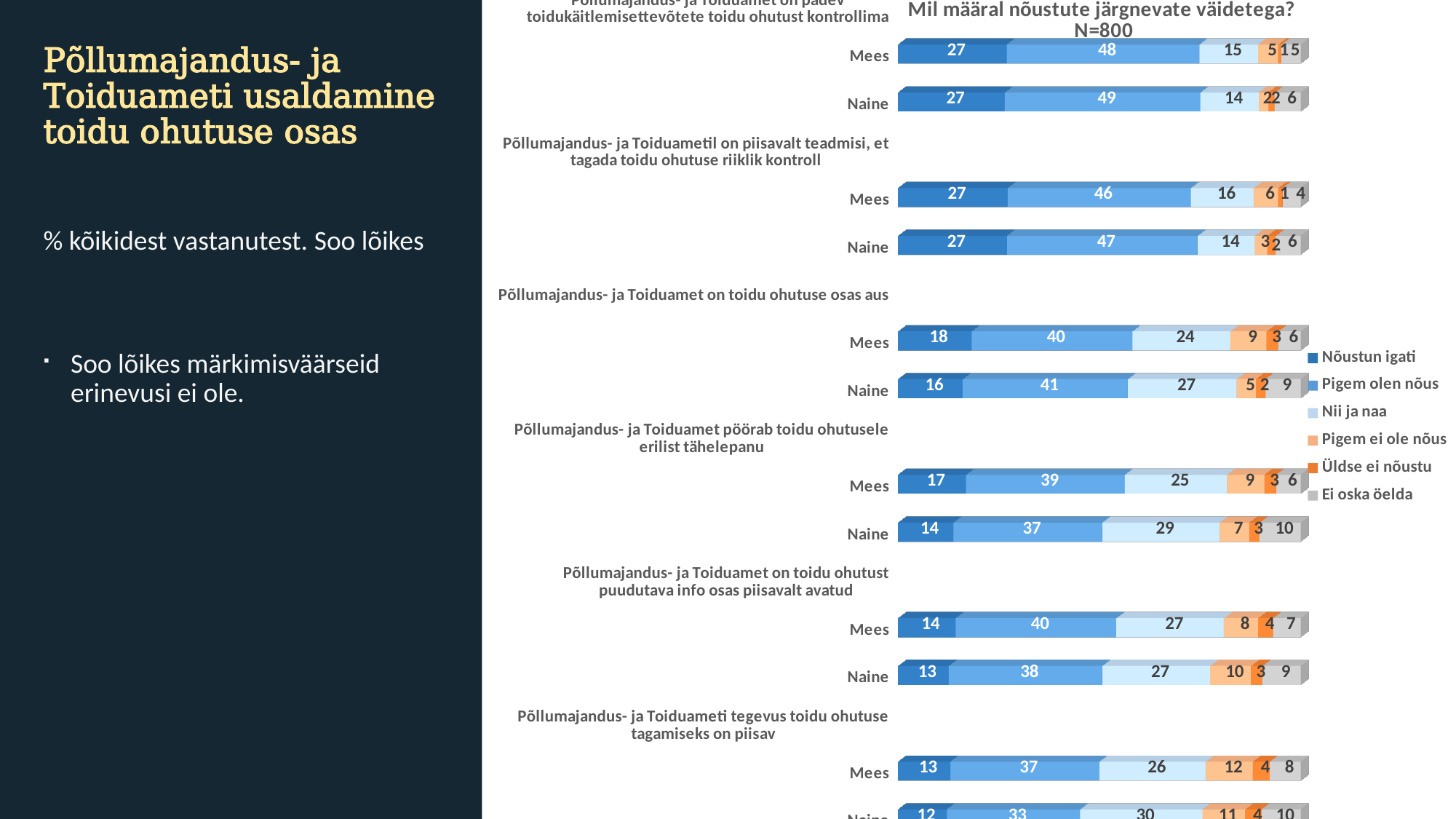
On the statement 'Põllumajandus- ja Toiduamet pöörab toidu ohutusele erilist tähelepanu', which has the larger 'Pigem olen nõus' value, Mees or Naine? Mees What is the 'Nõustun igati' value for Mees on the statement 'Põllumajandus- ja Toiduametil on piisavalt teadmisi, et tagada toidu ohutuse riiklik kontroll'? 27 What type of chart is shown on the slide? stacked bar chart On the statement 'Põllumajandus- ja Toiduamet on toidu ohutuse osas aus', what is the difference between the 'Nii ja naa' values for Naine and Mees? 3 What is the 'Pigem ei ole nõus' value for Naine on the statement 'Põllumajandus- ja Toiduamet on toidu ohutust puudutava info osas piisavalt avatud'? 10 What is the 'Pigem olen nõus' value for Naine on the statement 'Põllumajandus- ja Toiduamet on toidu ohutuse osas aus'? 41 Which legend entry is shown in dark grey? Ei oska öelda What is the 'Nii ja naa' value for Naine on the statement 'Põllumajandus- ja Toiduamet pöörab toidu ohutusele erilist tähelepanu'? 29 How many series does the legend list? 6 What is the 'Ei oska öelda' value for Mees on the statement 'Põllumajandus- ja Toiduameti tegevus toidu ohutuse tagamiseks on piisav'? 8 What sample size (N) is shown in the chart title? N=800 On the statement 'Põllumajandus- ja Toiduameti tegevus toidu ohutuse tagamiseks on piisav', what is the combined total of 'Nõustun igati' and 'Pigem olen nõus' for Mees? 50